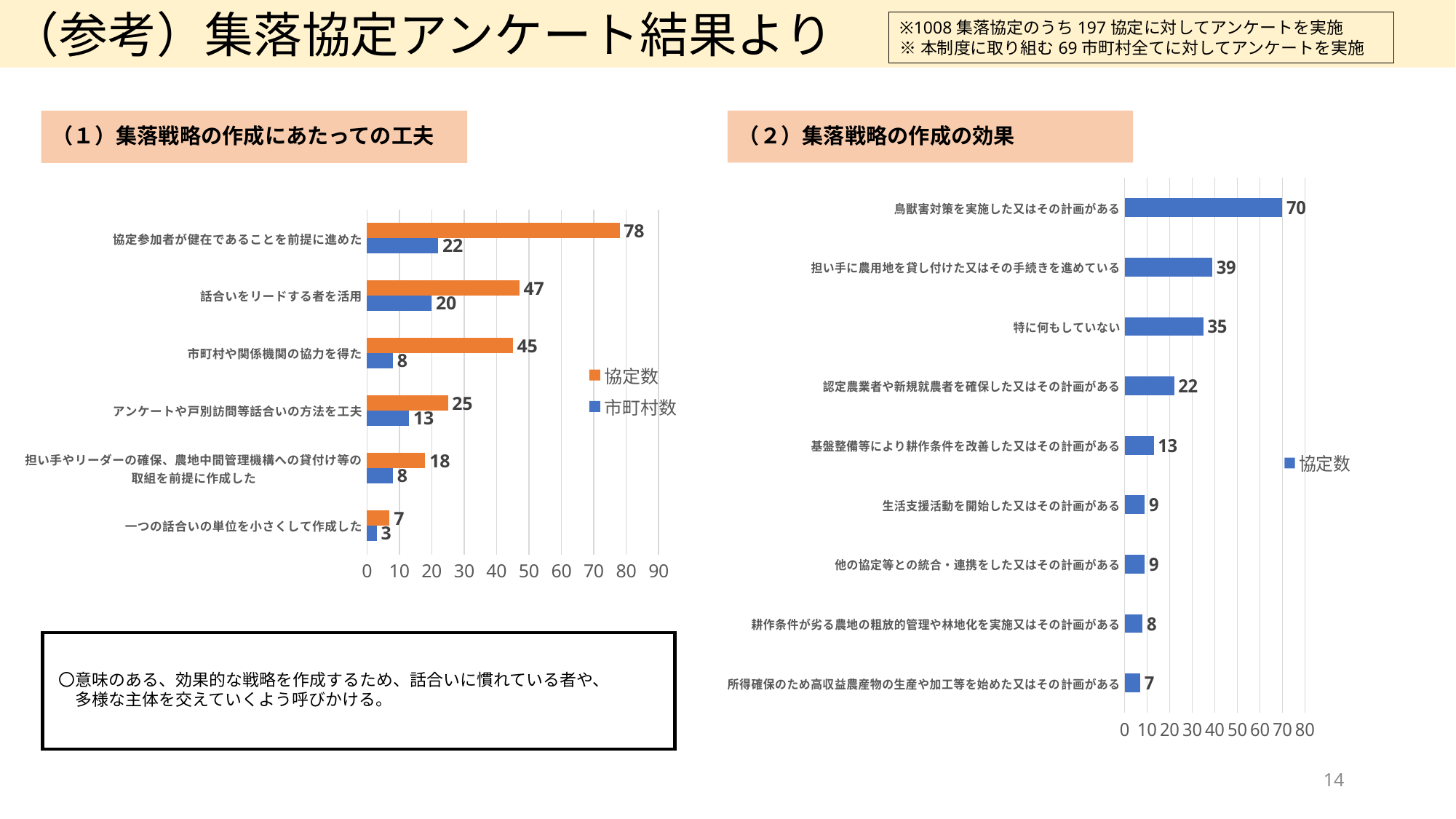
In the right chart (（２）集落戦略の作成の効果), which category has the highest value? 鳥獣害対策を実施した又はその計画がある In the left chart (（１）集落戦略の作成にあたっての工夫), what is the difference between the 協定数 and 市町村数 values for 市町村や関係機関の協力を得た? 37 In the right chart (（２）集落戦略の作成の効果), what is the difference between 鳥獣害対策を実施した又はその計画がある and 担い手に農用地を貸し付けた又はその手続きを進めている? 31 In the right chart (（２）集落戦略の作成の効果), what is the value for 特に何もしていない? 35 In the left chart (（１）集落戦略の作成にあたっての工夫), what is the 市町村数 value for 話合いをリードする者を活用? 20 In the left chart (（１）集落戦略の作成にあたっての工夫), what is the 協定数 value for 協定参加者が健在であることを前提に進めた? 78 In the right chart (（２）集落戦略の作成の効果), which is larger: 認定農業者や新規就農者を確保した又はその計画がある or 基盤整備等により耕作条件を改善した又はその計画がある? 認定農業者や新規就農者を確保した又はその計画がある In the left chart (（１）集落戦略の作成にあたっての工夫), how many categories are shown? 6 In the left chart (（１）集落戦略の作成にあたっての工夫), how many series does the legend list? 2 In the right chart (（２）集落戦略の作成の効果), how many categories are shown? 9 What kind of chart is the right chart (（２）集落戦略の作成の効果)? Bar chart In the left chart (（１）集落戦略の作成にあたっての工夫), which category has the lowest 協定数 value? 一つの話合いの単位を小さくして作成した